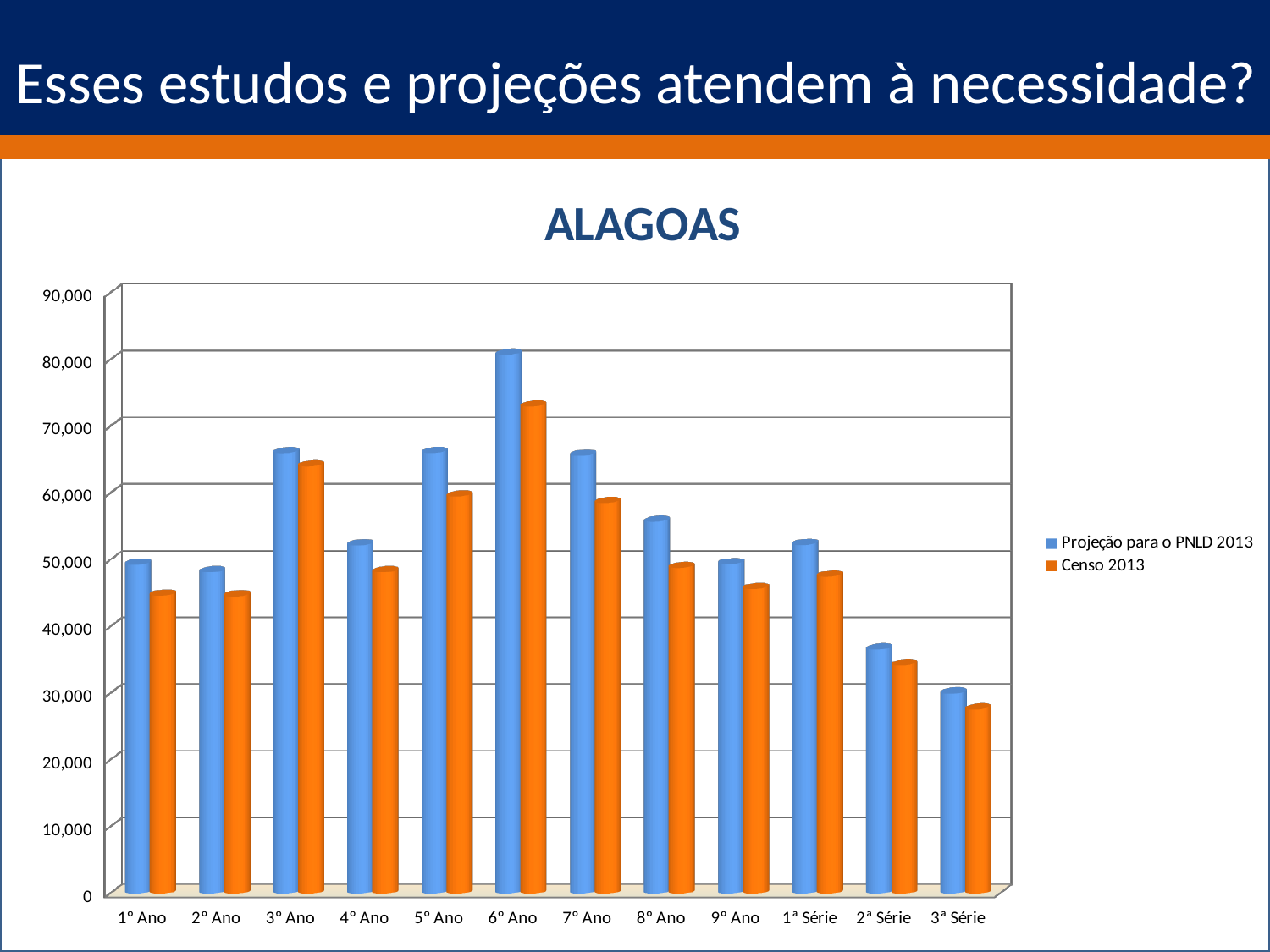
Which category has the lowest value for Censo 2013? 3ª Série For 6° Ano, which series has the larger value: Projeção para o PNLD 2013 or Censo 2013? Projeção para o PNLD 2013 Which category has the highest value for Projeção para o PNLD 2013? 6° Ano What is the title of the chart? ALAGOAS Is the Projeção para o PNLD 2013 value for 2ª Série greater or less than 40,000? less Is the Censo 2013 value for 1° Ano greater or less than 50,000? less How many categories are shown on the x axis? 12 Is the Censo 2013 value for 6° Ano greater or less than 70,000? greater How many series does the legend list? 2 What type of chart is shown on the slide? Bar chart Which is larger for Censo 2013: 3° Ano or 4° Ano? 3° Ano From 6° Ano to 3ª Série, do the Projeção para o PNLD 2013 values rise or fall? fall